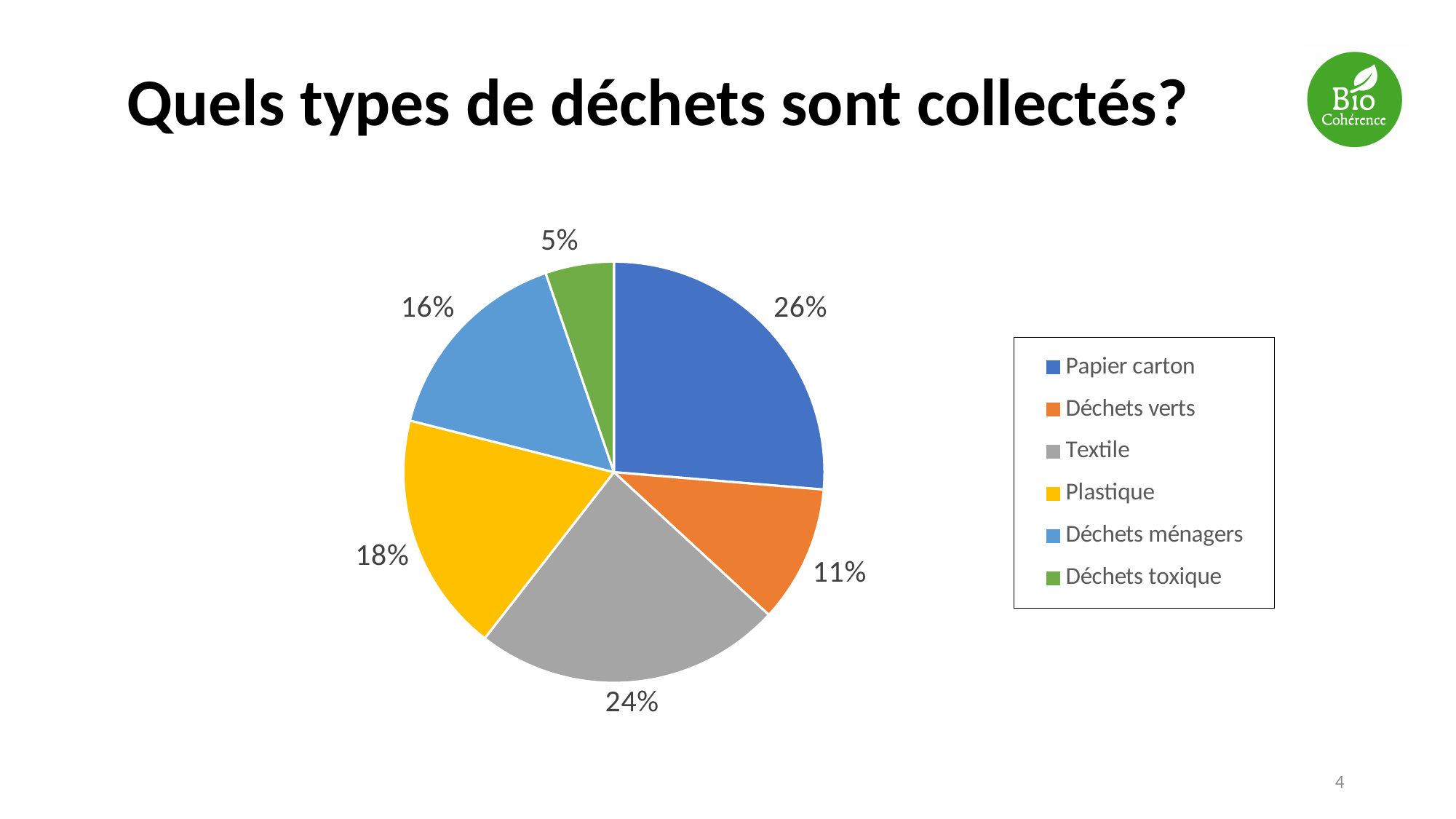
What is the value shown for Textile? 24% Which category has the smallest share of the pie? Déchets toxique What share of the pie does Papier carton represent? 26% What is the value shown for Déchets ménagers? 16% What is the difference between the shares of Papier carton and Déchets toxique? 21% How many categories does the legend list? 6 What is the value shown for Plastique? 18% Which category has the largest share of the pie? Papier carton What colour is the slice for Déchets toxique? green What kind of chart is shown on the slide? pie chart Which is larger, the share for Plastique or the share for Déchets ménagers? Plastique What is the value shown for Déchets verts? 11%